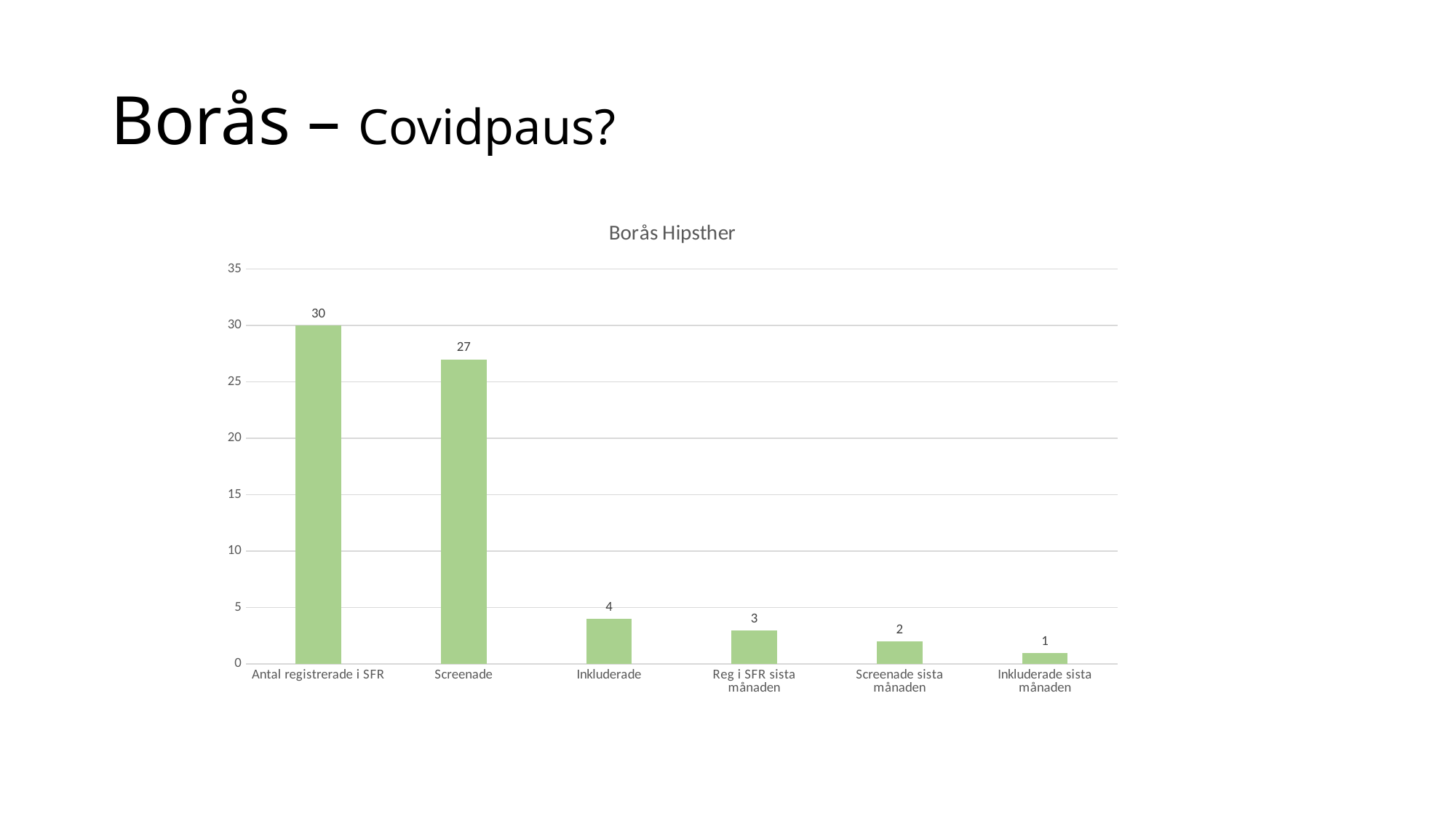
Which category has the lowest value? Inkluderade sista månaden What is the difference between Antal registrerade i SFR and Screenade? 3 What is the value for Inkluderade? 4 How many categories are shown on the x axis? 6 What kind of chart is this? Bar chart What is the value for Inkluderade sista månaden? 1 What is the value for Antal registrerade i SFR? 30 What is the title of the chart? Borås Hipsther Which is larger, Inkluderade or Screenade sista månaden? Inkluderade What is the value for Reg i SFR sista månaden? 3 Which category has the highest value? Antal registrerade i SFR What is the value for Screenade? 27